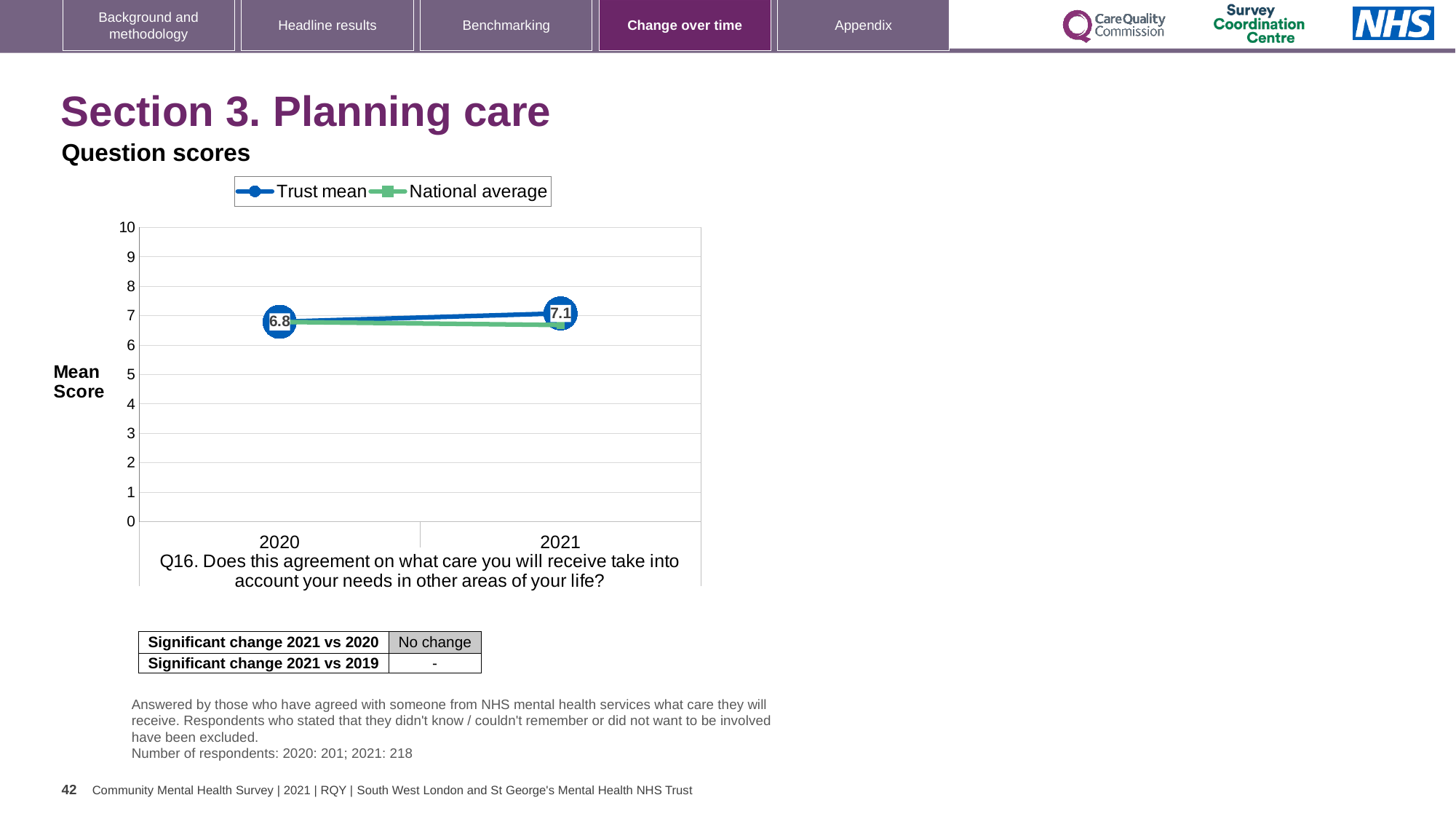
How many series does the chart legend list? 2 What kind of chart is shown on the slide? Line chart What is the difference between the Trust mean scores for 2021 and 2020? 0.3 What is the Trust mean score for 2021? 7.1 In which year is the Trust mean score highest? 2021 How many years are shown on the x axis of the chart? 2 What is the label on the y axis of the chart? Mean Score Does the Trust mean score rise or fall from 2020 to 2021? Rise Is the National average value for 2021 greater or less than 6? greater In which year is the Trust mean score lowest? 2020 Which is larger, the Trust mean score for 2020 or for 2021? 2021 What is the Trust mean score for 2020? 6.8